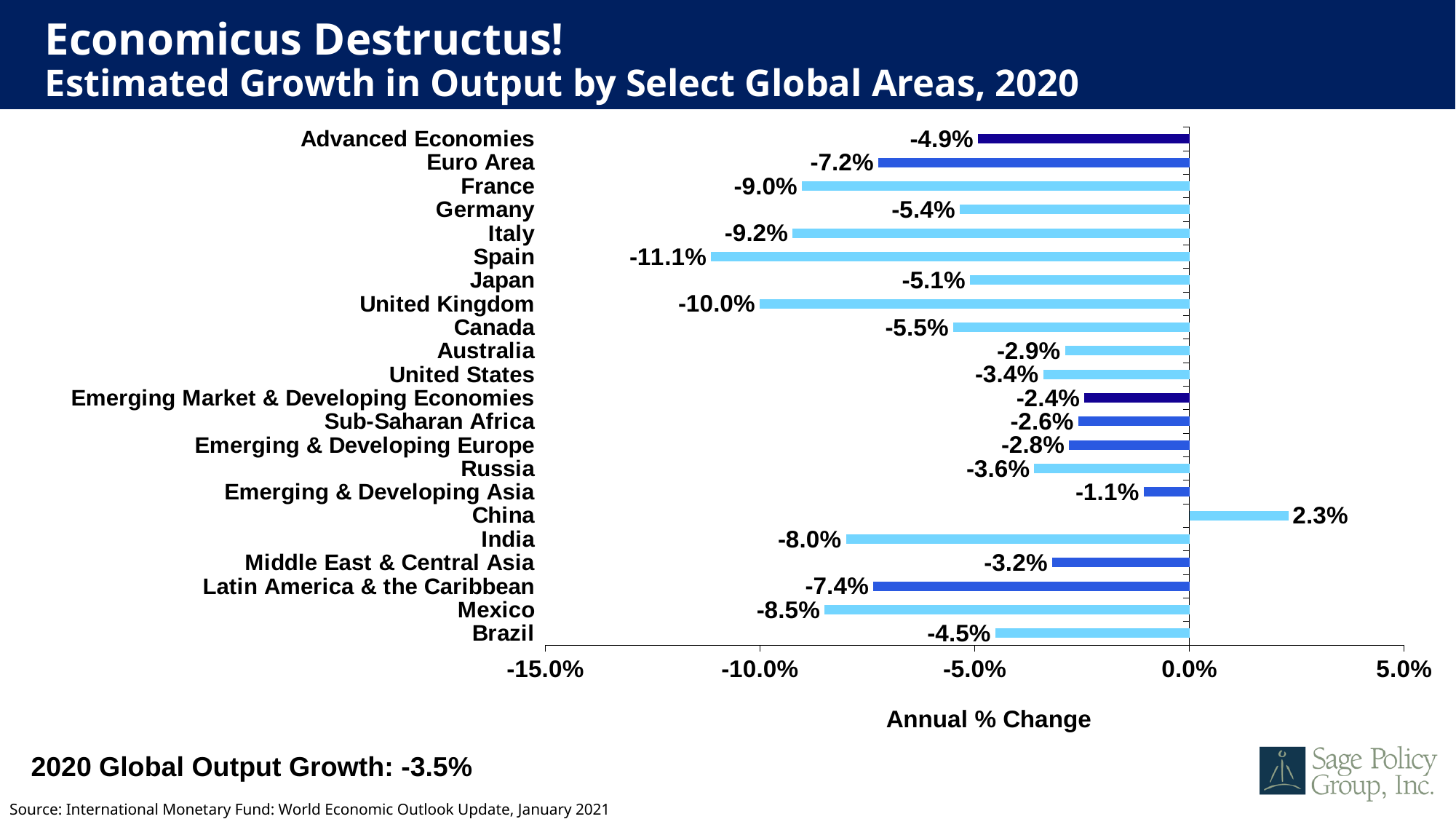
Which area has the lowest estimated growth in output for 2020? Spain Which has the larger (less negative) estimated growth in output, Italy or Japan? Japan What is the estimated 2020 growth in output for China? 2.3% What is the estimated 2020 growth in output for Spain? -11.1% What kind of chart is shown on the slide? Bar chart How many areas are plotted in the chart? 22 Which area has the highest estimated growth in output for 2020? China What is the estimated 2020 growth in output for Latin America & the Caribbean? -7.4% What is the label of the horizontal axis of the chart? Annual % Change What is the difference in percentage points between the values for France (-9.0%) and Germany (-5.4%)? 3.6 percentage points What is the estimated 2020 growth in output for the United States? -3.4% Is the value for the United Kingdom greater or less than -5.0%? less